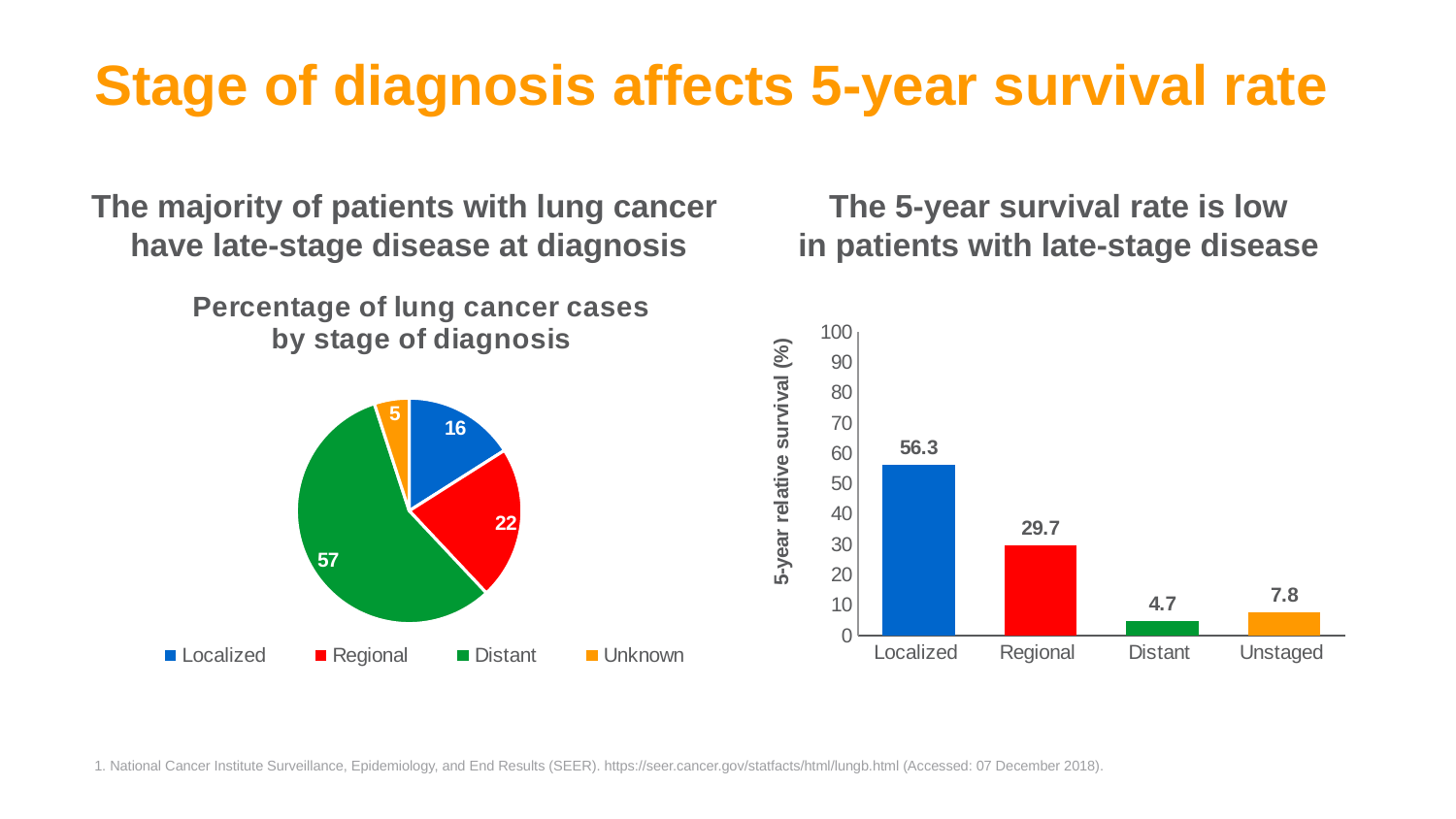
In the pie chart 'Percentage of lung cancer cases by stage of diagnosis', which stage has the smallest slice? Unknown What type of chart is shown on the right side of the slide? Bar chart In the bar chart on the right showing 5-year relative survival (%), what is the value for Localized? 56.3 In the pie chart 'Percentage of lung cancer cases by stage of diagnosis', what is the difference between the Regional and Localized values? 6 In the pie chart 'Percentage of lung cancer cases by stage of diagnosis', what is the value for Distant? 57 In the pie chart 'Percentage of lung cancer cases by stage of diagnosis', which stage has the largest slice? Distant In the bar chart on the right showing 5-year relative survival (%), what is the value for Distant? 4.7 In the bar chart on the right showing 5-year relative survival (%), which category has the lowest value? Distant In the pie chart 'Percentage of lung cancer cases by stage of diagnosis', how many categories does the legend list? 4 In the bar chart on the right showing 5-year relative survival (%), which is larger, Unstaged or Distant? Unstaged In the pie chart 'Percentage of lung cancer cases by stage of diagnosis', what is the value for Localized? 16 In the bar chart on the right showing 5-year relative survival (%), what is the difference between the Localized and Regional values? 26.6